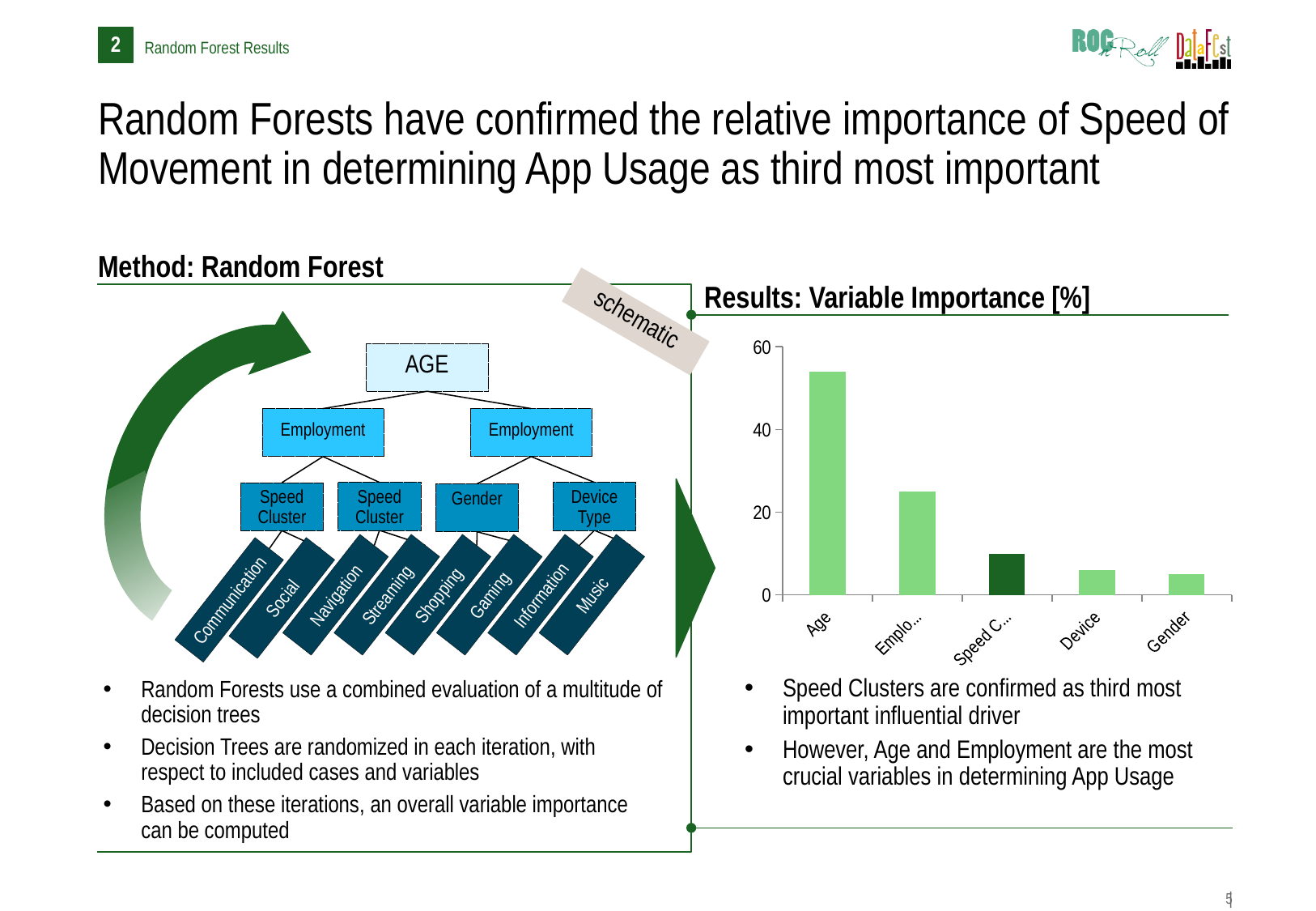
In the Variable Importance chart, is the value for Device greater or less than 20? less In the Variable Importance chart, is the value for Age greater or less than 60? less In the Variable Importance chart, which is larger: the value for Emplo... or the value for Speed C...? Emplo... Which category has the highest value in the Variable Importance chart? Age Which bar in the Variable Importance chart is drawn in a darker green than the others? Speed C... In the Variable Importance chart, is the value for Speed C... greater or less than 20? less How many categories are plotted in the Variable Importance chart? 5 What kind of chart is shown under "Results: Variable Importance [%]"? bar chart In the Variable Importance chart, which is larger: the value for Age or the value for Device? Age Do the values in the Variable Importance chart rise or fall from left to right along the x axis? fall